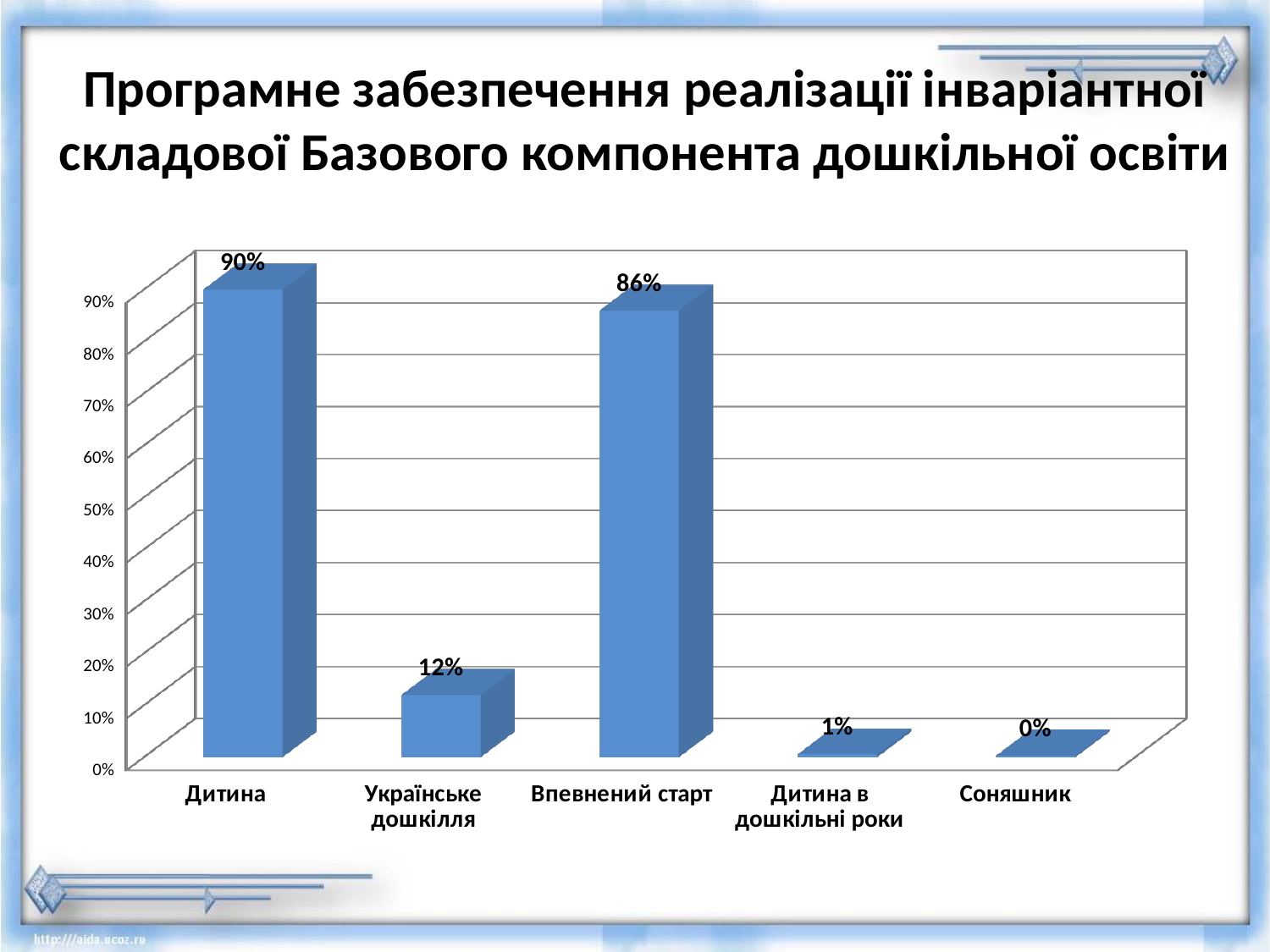
What is the difference between the values for Дитина and Впевнений старт? 4% Which is larger, the value for Українське дошкілля or the value for Дитина в дошкільні роки? Українське дошкілля What is the difference between the values for Впевнений старт and Українське дошкілля? 74% What is the value for Впевнений старт? 86% What is the value for Українське дошкілля? 12% Which category has the lowest value? Соняшник How many categories are shown on the x axis? 5 What is the value for Дитина в дошкільні роки? 1% What is the title of the slide? Програмне забезпечення реалізації інваріантної складової Базового компонента дошкільної освіти Which category has the highest value? Дитина What is the value for Дитина? 90% What kind of chart is shown on the slide? Bar chart